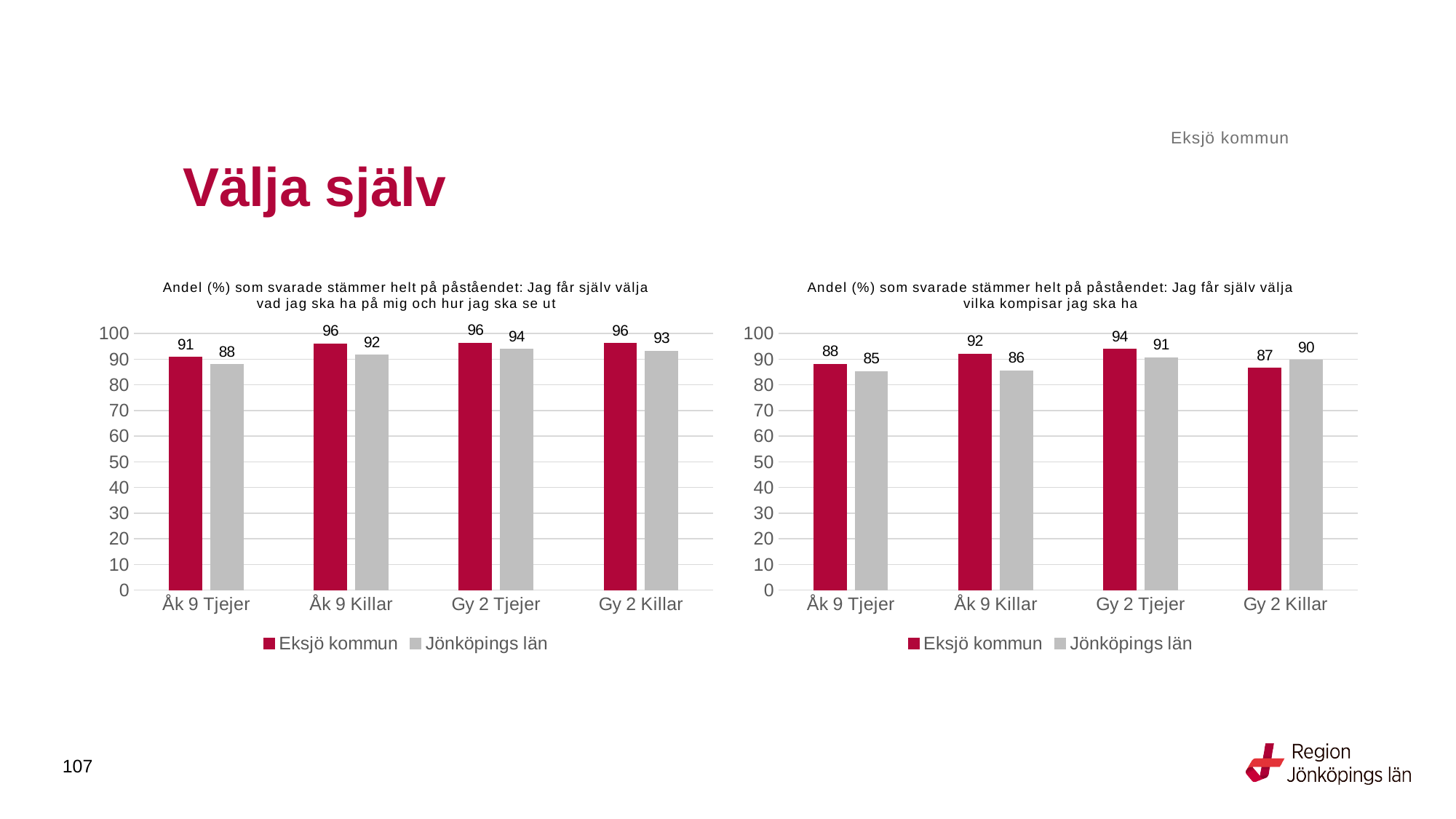
In the right chart (about choosing friends), which is larger for Gy 2 Killar: Eksjö kommun or Jönköpings län? Jönköpings län In the right chart (about choosing friends), what is the difference between Eksjö kommun and Jönköpings län for Åk 9 Killar? 6 In the right chart (about choosing friends), what is the value for Jönköpings län for Gy 2 Killar? 90 How many categories are shown on the x axis of the left chart? 4 In the left chart (about choosing what to wear and how to look), which is larger for Gy 2 Tjejer: Eksjö kommun or Jönköpings län? Eksjö kommun In the left chart (about choosing what to wear and how to look), what is the value for Eksjö kommun for Åk 9 Tjejer? 91 What kind of chart is the left chart? Bar chart In the right chart (about choosing friends), which category has the highest value for Eksjö kommun? Gy 2 Tjejer In the right chart (about choosing friends), which category has the lowest value for Jönköpings län? Åk 9 Tjejer How many series does the legend of the right chart list? 2 In the left chart (about choosing what to wear and how to look), what is the difference between Eksjö kommun and Jönköpings län for Åk 9 Killar? 4 In the left chart (about choosing what to wear and how to look), which category has the lowest value for Eksjö kommun? Åk 9 Tjejer